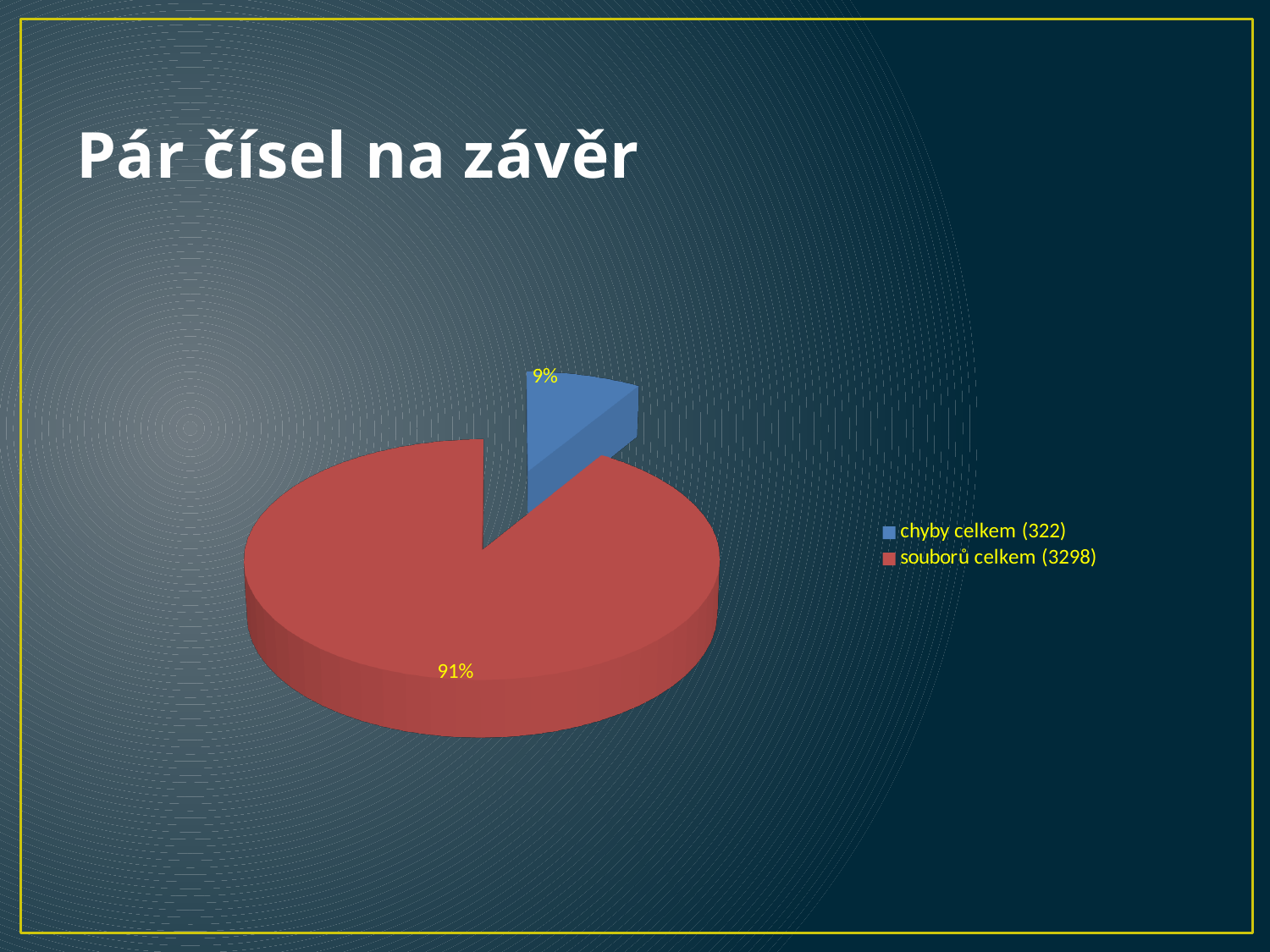
Which is larger, the "chyby celkem (322)" slice or the "souborů celkem (3298)" slice? souborů celkem (3298) What share of the pie does "souborů celkem (3298)" represent? 91% What colour is the "chyby celkem (322)" slice? blue What is the title of the slide containing the pie chart? Pár čísel na závěr What share of the pie does "chyby celkem (322)" represent? 9% Which slice of the pie is the largest? souborů celkem (3298) How many slices does the pie chart have? 2 How many entries does the legend list? 2 Which slice of the pie is the smallest? chyby celkem (322) What is the difference in percentage points between the "souborů celkem (3298)" slice and the "chyby celkem (322)" slice? 82 percentage points What kind of chart is shown on the slide? pie chart